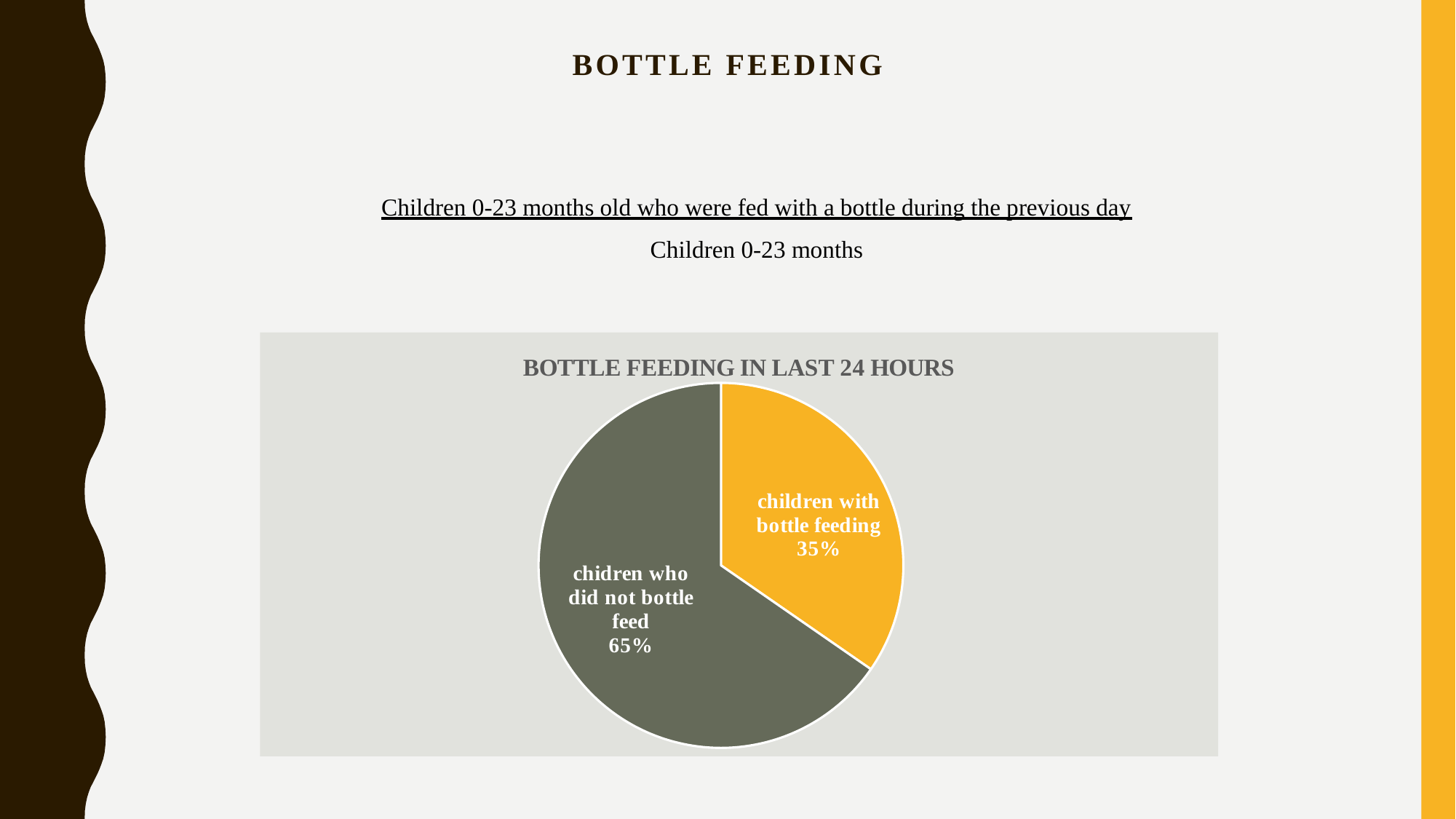
Which slice of the pie is the smallest? children with bottle feeding What colour is the slice for children with bottle feeding? yellow What share of the pie does the 'children with bottle feeding' slice represent? 35% What is the title of the chart? BOTTLE FEEDING IN LAST 24 HOURS How many slices does the pie chart have? 2 Which is larger: the share of children with bottle feeding or the share of children who did not bottle feed? chidren who did not bottle feed What percentage of children were fed with a bottle in the last 24 hours? 35% What is the difference in percentage points between children who did not bottle feed and children with bottle feeding? 30 What percentage of children did not bottle feed? 65% What kind of chart is shown on the slide? pie chart Which slice of the pie is the largest? chidren who did not bottle feed